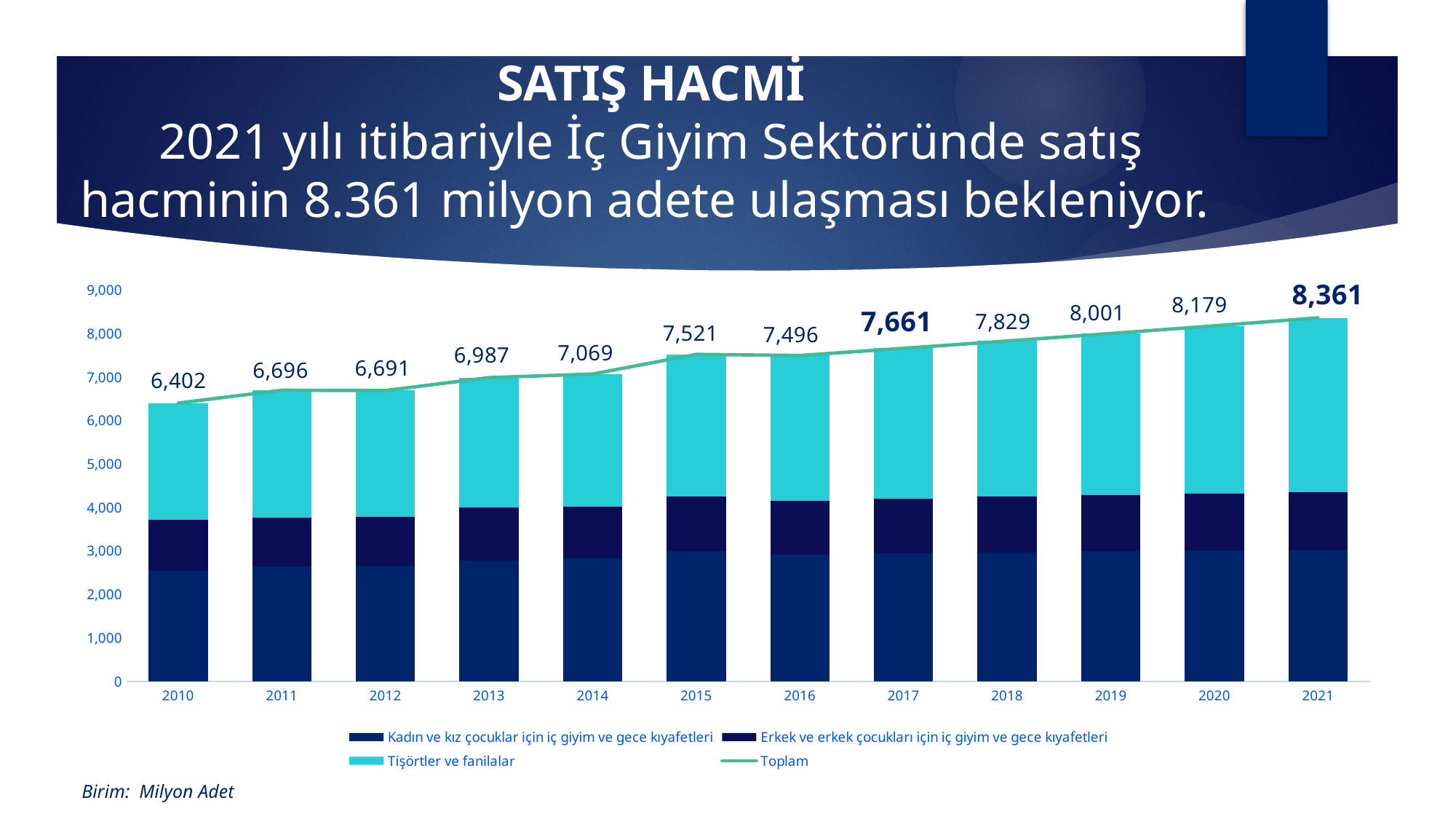
What is the Toplam value for 2017? 7,661 How many years are shown on the x axis? 12 Does the Toplam value generally rise or fall from 2010 to 2021? rise What kind of chart is shown on the slide? stacked bar chart with a line What is the Toplam value shown for 2021? 8,361 What is the Toplam (total) value for 2010? 6,402 Which year has the highest Toplam value? 2021 Which year has the lowest Toplam value? 2010 Which year has the larger Toplam value, 2015 or 2016? 2015 How many series does the legend list? 4 What is the difference between the Toplam values for 2021 and 2010? 1,959 Is the value for 'Kadın ve kız çocuklar için iç giyim ve gece kıyafetleri' in 2010 greater or less than 3,000? less